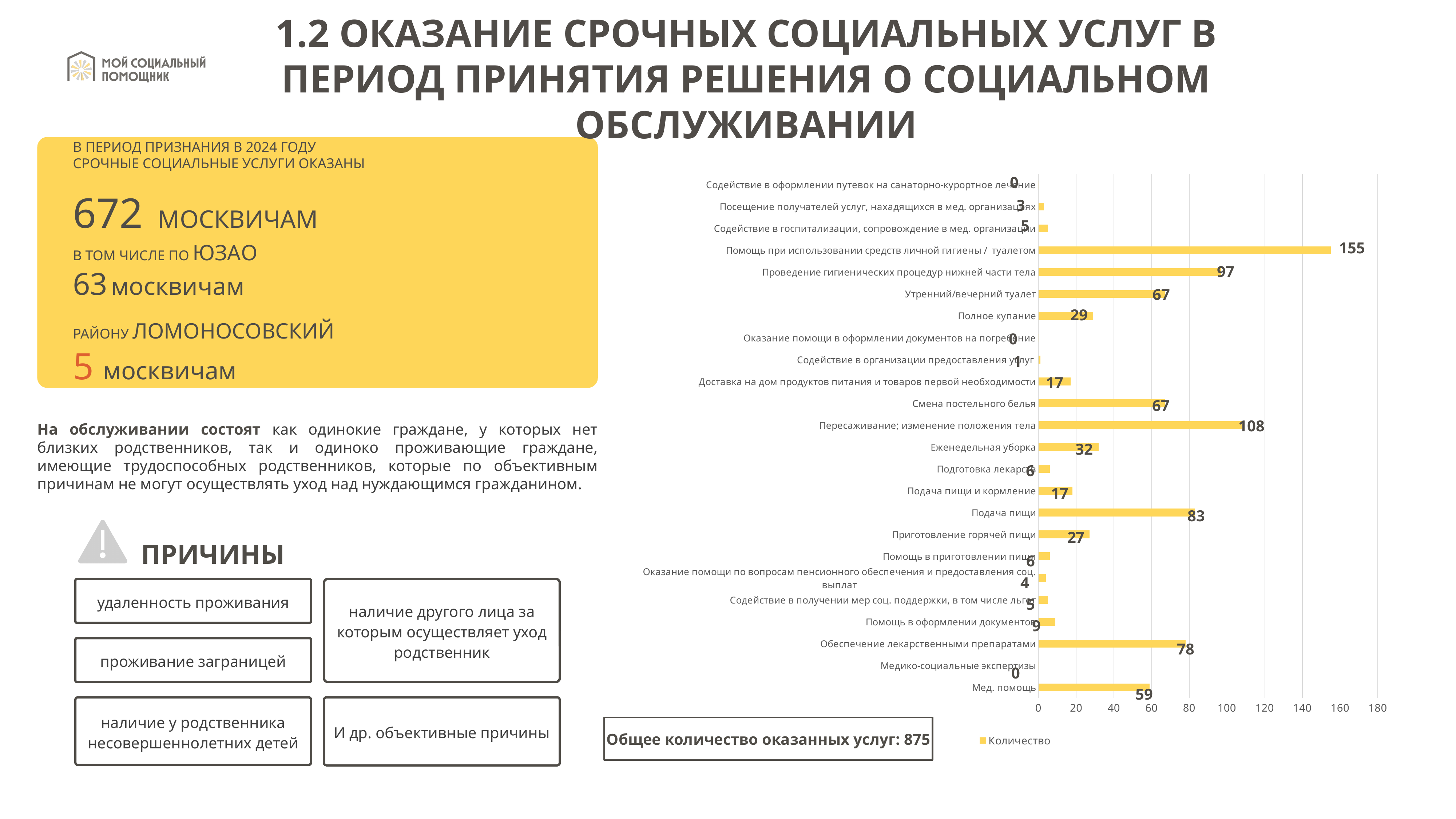
Which is larger: the value for "Подача пищи" or the value for "Приготовление горячей пищи"? Подача пищи Which category has the highest value in the chart? Помощь при использовании средств личной гигиены / туалетом What is the value for "Пересаживание; изменение положения тела"? 108 What is the value for "Мед. помощь"? 59 What is the value for "Помощь при использовании средств личной гигиены / туалетом"? 155 What is the name of the series shown in the chart legend? Количество What type of chart is shown on the slide? bar chart What is the difference between the values for "Проведение гигиенических процедур нижней части тела" and "Полное купание"? 68 Is the value for "Еженедельная уборка" greater or less than 40? less How many series does the chart legend list? 1 How many categories are plotted in the chart? 24 What is the value for "Обеспечение лекарственными препаратами"? 78